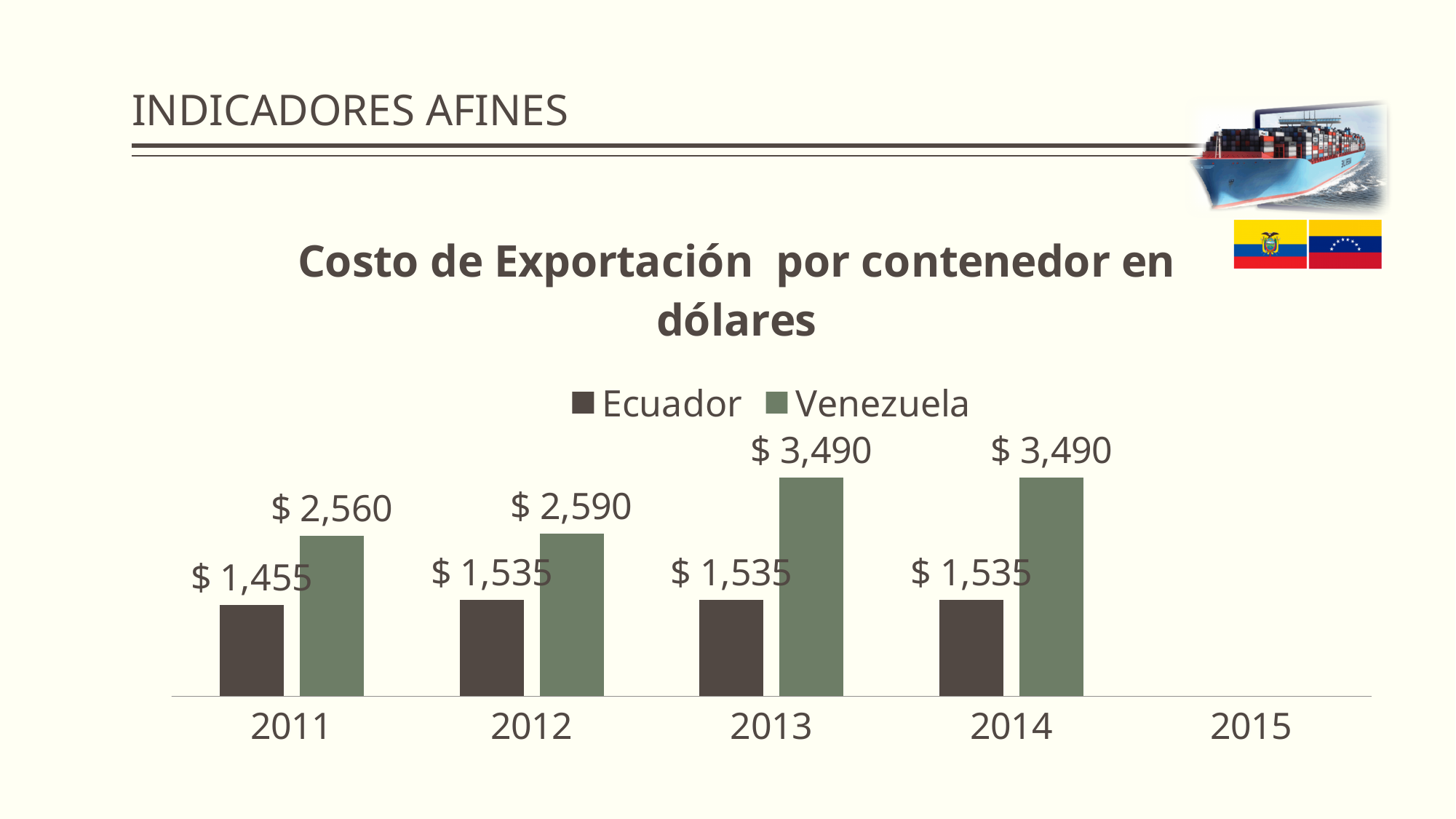
What kind of chart is shown on the slide? Bar chart Which country has the higher export cost per container in 2012? Venezuela Does the Venezuela export cost per container rise or fall from 2011 to 2013? Rise How many series does the legend list? 2 In which year is the Ecuador export cost per container lowest? 2011 What is the difference between the Venezuela and Ecuador export cost per container in 2014? $ 1,955 In which year is the Venezuela export cost per container lowest? 2011 What is the export cost per container for Venezuela in 2013? $ 3,490 What is the export cost per container for Ecuador in 2011? $ 1,455 What is the difference between the Venezuela export cost in 2013 and in 2012? $ 900 What is the export cost per container for Venezuela in 2012? $ 2,590 What is the export cost per container for Ecuador in 2014? $ 1,535